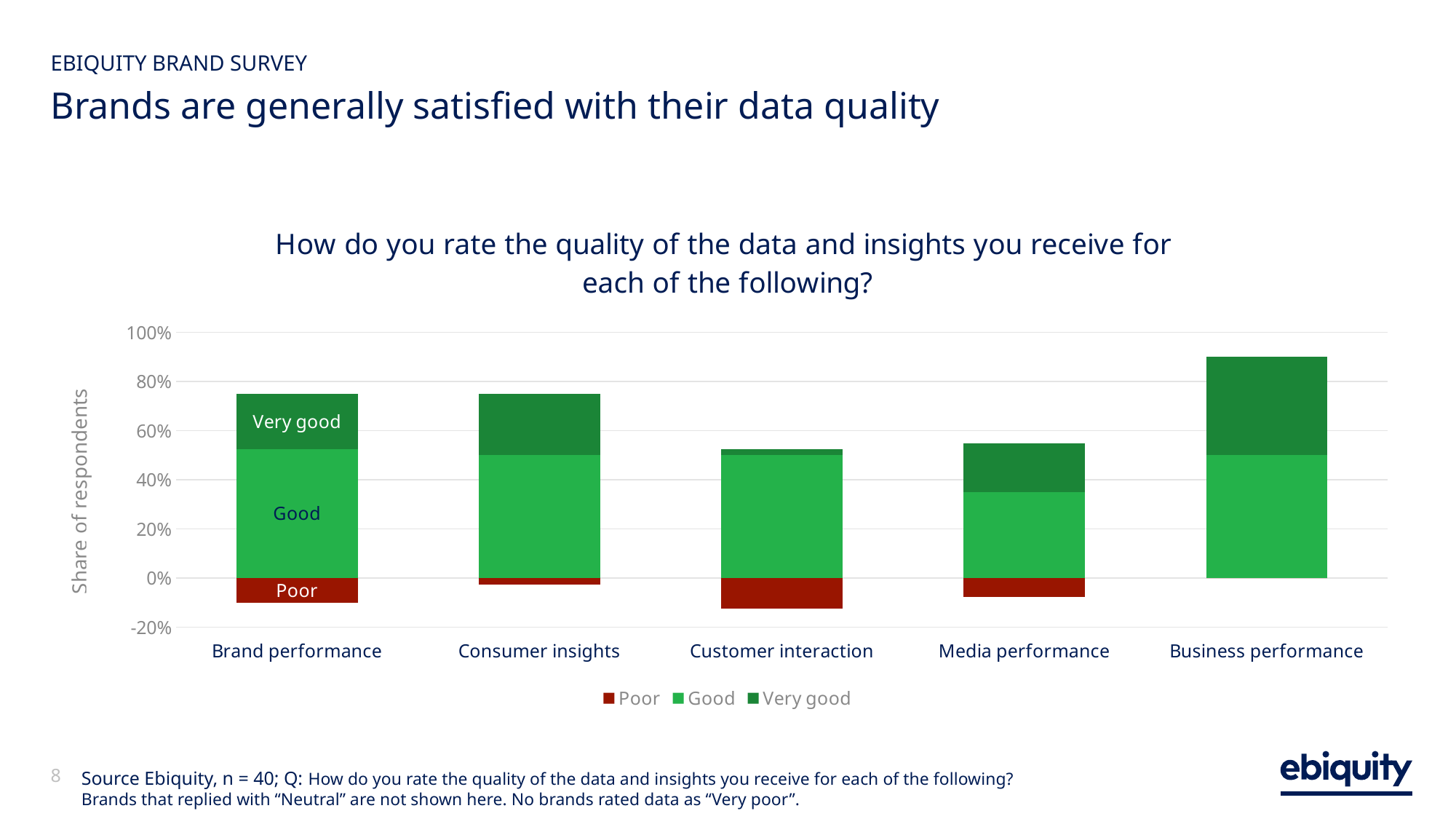
What kind of chart is shown on the slide? Stacked bar chart Which category has the tallest combined Good and Very good stack? Business performance Which has the larger Good segment, Business performance or Media performance? Business performance How many series does the chart legend list? 3 What is the label on the vertical axis of the chart? Share of respondents Which category has the smallest Very good segment? Customer interaction Which category shows no Poor segment at all? Business performance Which category has the largest Poor segment? Customer interaction Is the top of the positive stack for Brand performance greater or less than 60%? greater Is the top of the positive stack for Media performance greater or less than 60%? less How many categories are shown on the x axis of the chart? 5 Is the top of the positive stack for Business performance greater or less than 80%? greater